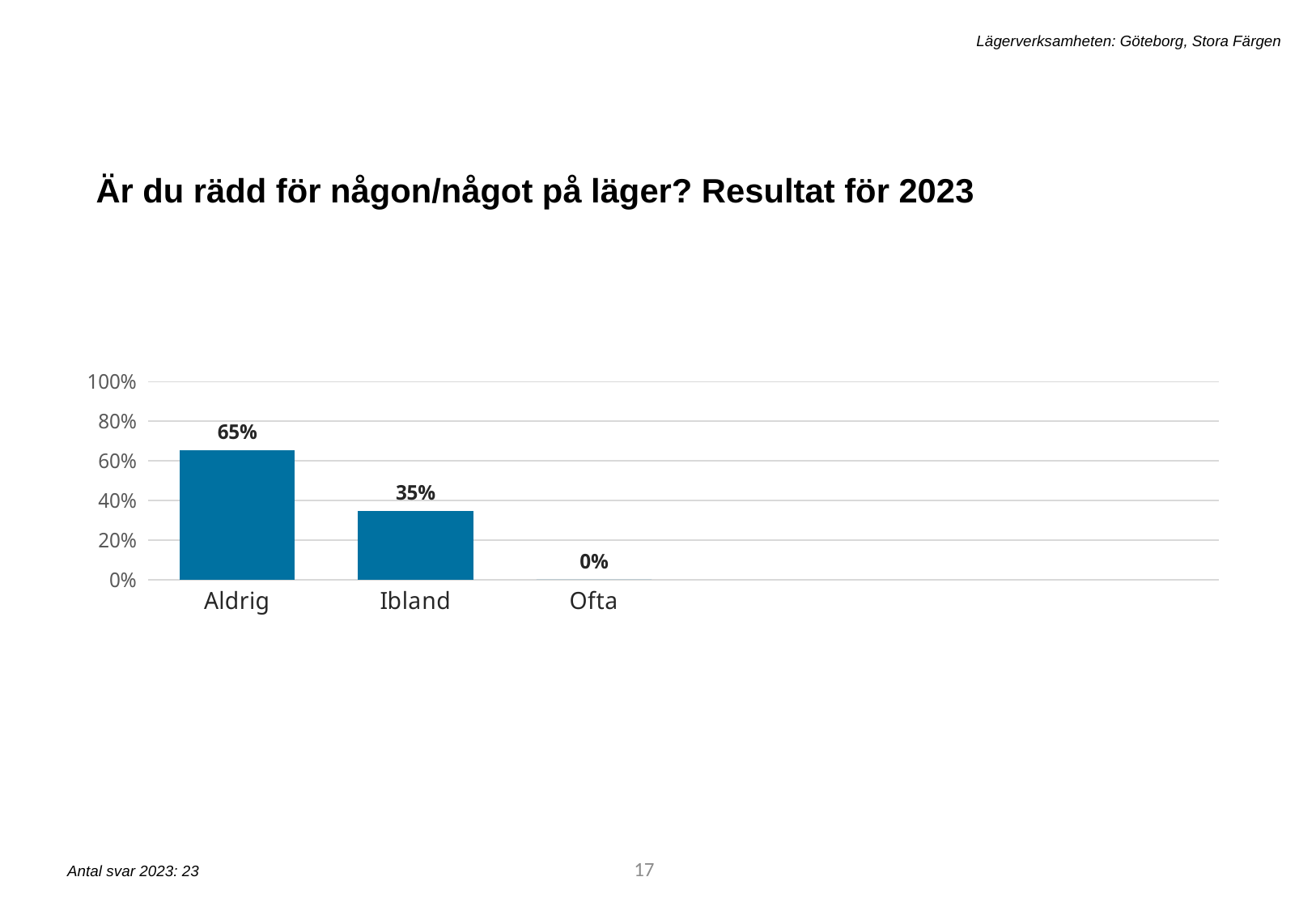
Which category has the highest value? Aldrig What is the title of the slide containing the chart? Är du rädd för någon/något på läger? Resultat för 2023 What is the value for Ofta? 0% What kind of chart is shown on the slide? bar chart How many categories are shown on the x axis? 3 Is the value for Aldrig greater or less than 60%? greater What is the difference between the values for Aldrig and Ibland? 30% What is the value for Ibland? 35% What is the value for Aldrig? 65% Which category has the lowest value? Ofta Do the values rise or fall from left to right along the x axis? fall Which is larger, the value for Ibland or the value for Ofta? Ibland